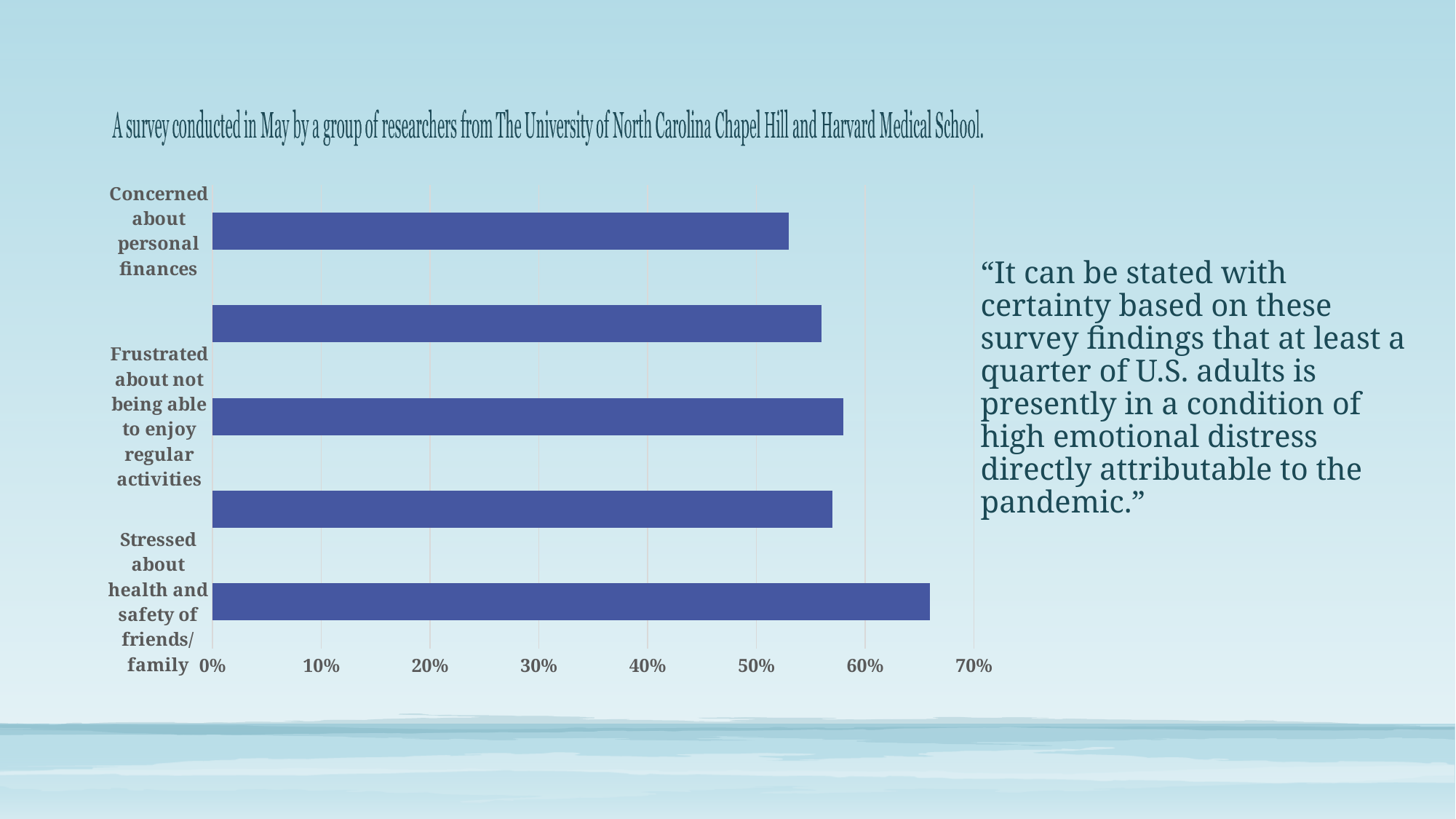
Which category has the highest value in the chart? Stressed about health and safety of friends/family Which is larger: the value for 'Stressed about health and safety of friends/family' or the value for 'Concerned about personal finances'? Stressed about health and safety of friends/family Is the value for 'Stressed about health and safety of friends/family' greater or less than 60%? greater How many bars are plotted in the chart? 5 What kind of chart is shown on the slide? Bar chart Is the value for 'Concerned about personal finances' greater or less than 60%? less Is the value for 'Frustrated about not being able to enjoy regular activities' greater or less than 60%? less What is the highest value shown on the chart's horizontal axis? 70% Which is larger: the value for 'Frustrated about not being able to enjoy regular activities' or the value for 'Concerned about personal finances'? Frustrated about not being able to enjoy regular activities What colour are the bars in the chart? Blue